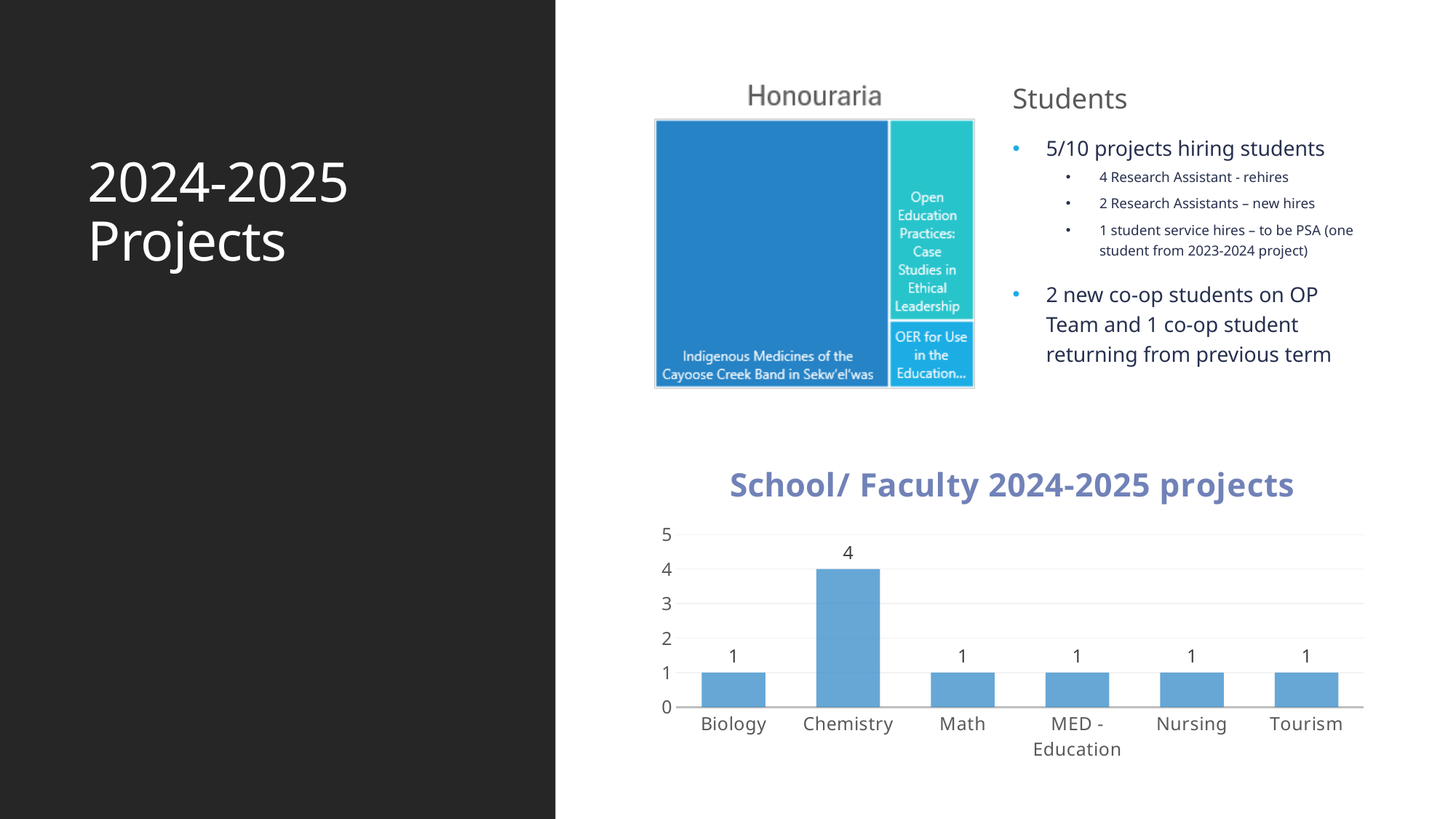
In the 'Honouraria' chart, which project occupies the largest area? Indigenous Medicines of the Cayoose Creek Band in Sekw'el'was In the 'School/ Faculty 2024-2025 projects' chart, which school or faculty has the highest number of projects? Chemistry In the 'School/ Faculty 2024-2025 projects' chart, what is the total number of projects across all schools and faculties? 10 In the 'School/ Faculty 2024-2025 projects' chart, what is the value for Nursing? 1 In the 'School/ Faculty 2024-2025 projects' chart, how many schools or faculties are shown on the x axis? 6 How many project segments are shown in the 'Honouraria' chart? 3 In the 'School/ Faculty 2024-2025 projects' chart, what is the difference between the values for Chemistry and Biology? 3 What kind of chart is the 'School/ Faculty 2024-2025 projects' chart? Bar chart In the 'School/ Faculty 2024-2025 projects' chart, which is larger, the value for Chemistry or the value for Tourism? Chemistry In the 'School/ Faculty 2024-2025 projects' chart, how many projects does Chemistry have? 4 What kind of chart is the 'Honouraria' chart? Treemap In the 'School/ Faculty 2024-2025 projects' chart, what is the highest value shown on the vertical axis? 5